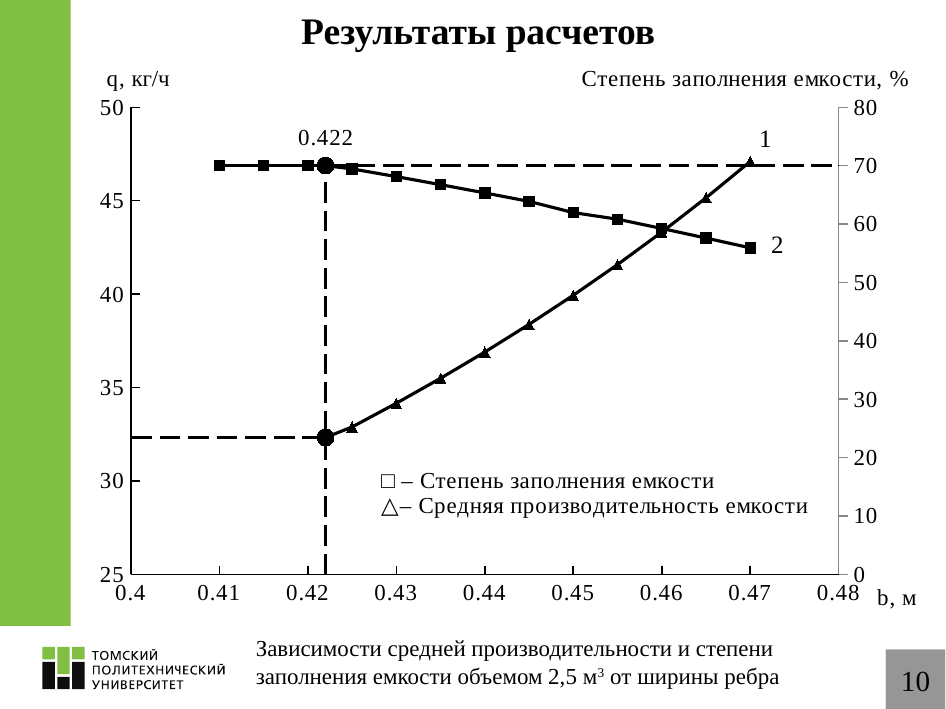
Does the series 'Средняя производительность емкости' (triangles) rise or fall as b increases? rise Does the series 'Степень заполнения емкости' (squares) rise or fall as b increases? fall Is the value of 'Степень заполнения емкости' (squares) at b = 0.45 greater or less than 60%? greater Which series is labelled '1' on the chart, the squares or the triangles? triangles Is the value of 'Средняя производительность емкости' (triangles) at b = 0.47 greater or less than 45 кг/ч? greater Is the value of 'Степень заполнения емкости' (squares) at b = 0.47 greater or less than 60%? less What kind of chart is shown on the slide? line chart At which value of b does the 'Средняя производительность емкости' (triangles) series reach its highest point? 0.47 What is the title of the slide chart? Результаты расчетов What is the value of b, м marked by the vertical dashed line on the chart? 0.422 How many series does the legend list? 2